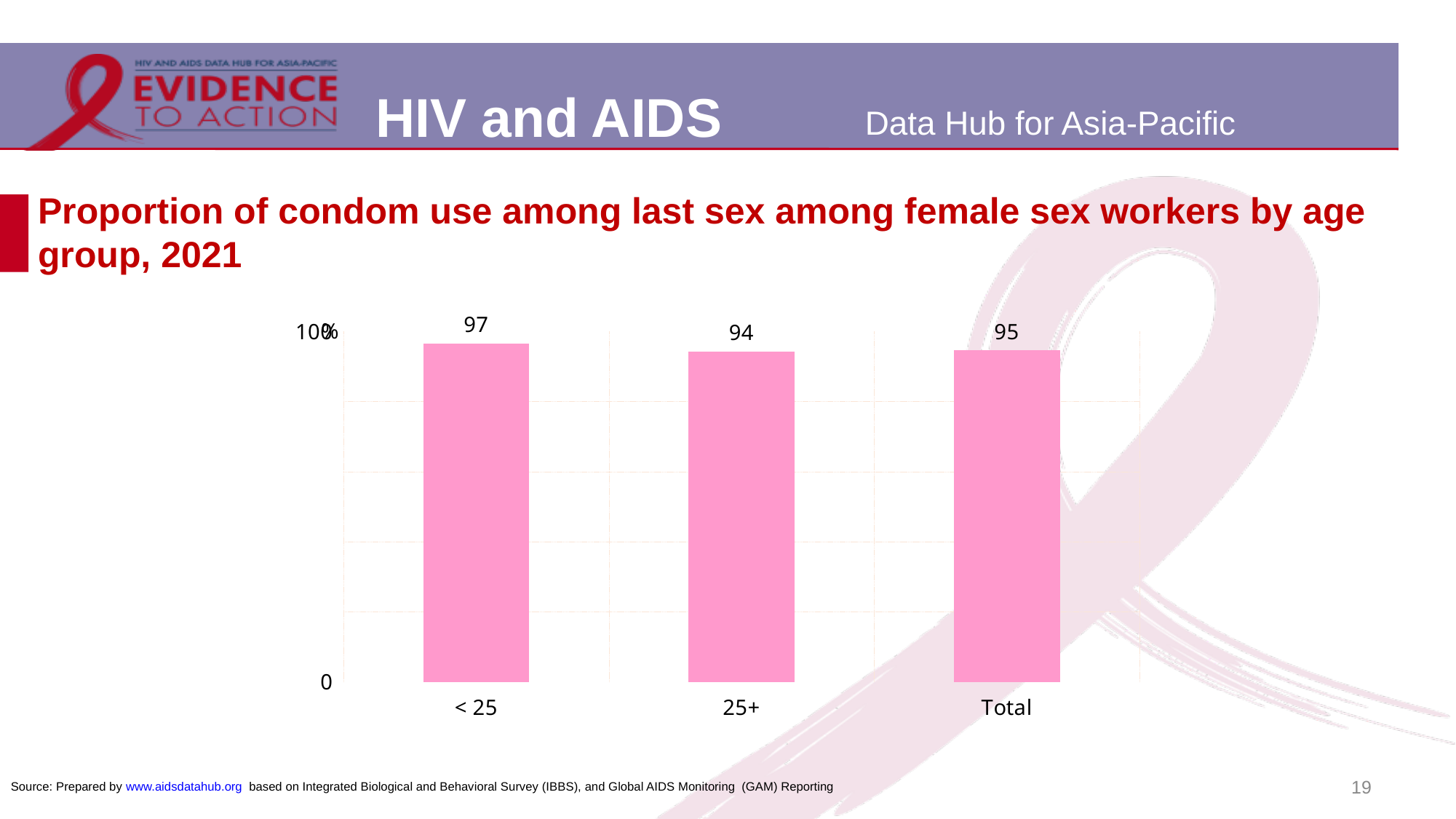
What is the title of the chart on the slide? Proportion of condom use among last sex among female sex workers by age group, 2021 Which category has the lowest value? 25+ What colour are the bars in the chart? pink What is the value for the 25+ age group? 94 What is the value for Total? 95 Which is larger, the value for < 25 or the value for Total? < 25 What is the difference between the values for Total and 25+? 1 What is the value for the < 25 age group? 97 What is the difference between the values for < 25 and 25+? 3 Which category has the highest value? < 25 How many categories are shown on the x axis? 3 What kind of chart is shown on the slide? bar chart